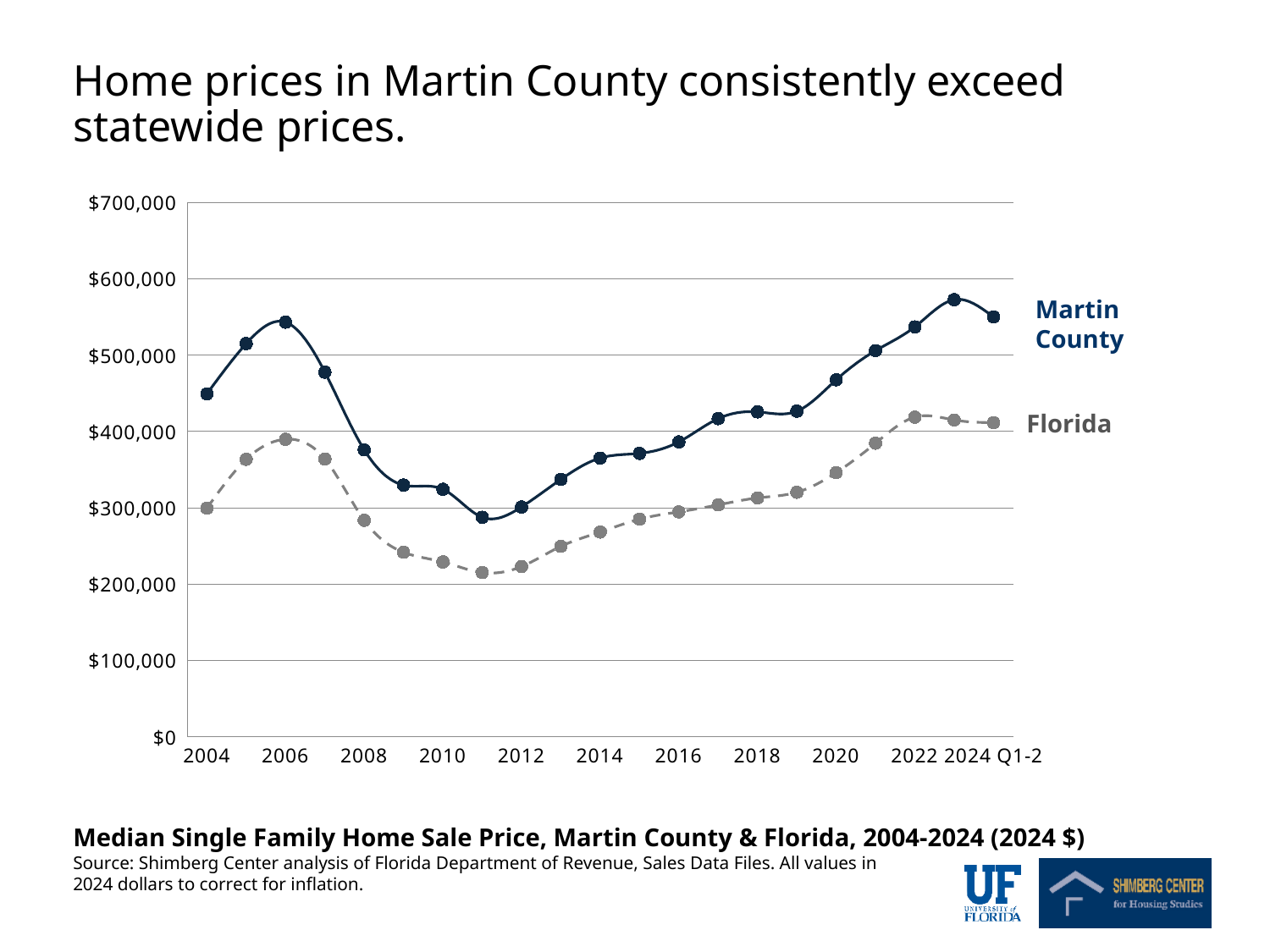
Is the Martin County value for 2004 greater or less than $400,000? greater In which year does the Martin County series reach its highest value? 2023 What are the two series plotted on the chart? Martin County and Florida What kind of chart is shown on the slide? line chart Is the Martin County value for 2023 greater or less than $500,000? greater How many data points does each series have on the chart? 21 Is the Martin County value for 2008 greater or less than $400,000? less In 2006, which series has the higher value, Martin County or Florida? Martin County Does the Martin County series rise or fall between 2011 and 2023? rise How many series does the chart show? 2 What is the title of the chart? Median Single Family Home Sale Price, Martin County & Florida, 2004-2024 (2024 $)